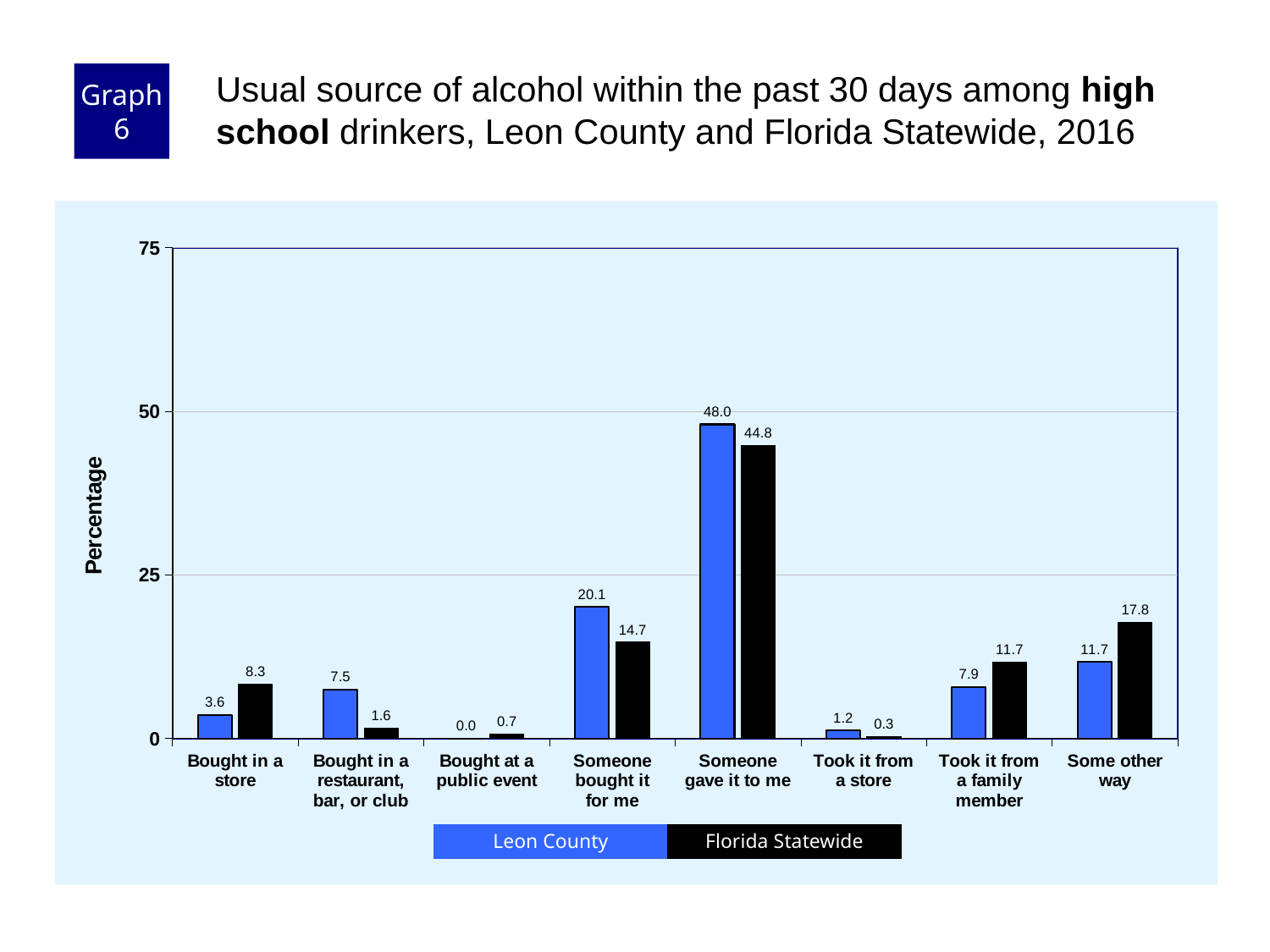
How many categories are shown on the x axis? 8 For "Bought in a restaurant, bar, or club", which is larger: Leon County or Florida Statewide? Leon County What is the Florida Statewide value for "Some other way"? 17.8 Which category has the lowest Leon County value? Bought at a public event Is the Leon County value for "Someone gave it to me" greater or less than 25? greater Which category has the highest Florida Statewide value? Someone gave it to me How many series does the legend list? 2 What is the difference between the Leon County and Florida Statewide values for "Someone bought it for me"? 5.4 What is the label on the y axis? Percentage What is the Leon County value for "Someone gave it to me"? 48.0 What is the Leon County value for "Bought at a public event"? 0.0 What kind of chart is shown on the slide? Bar chart